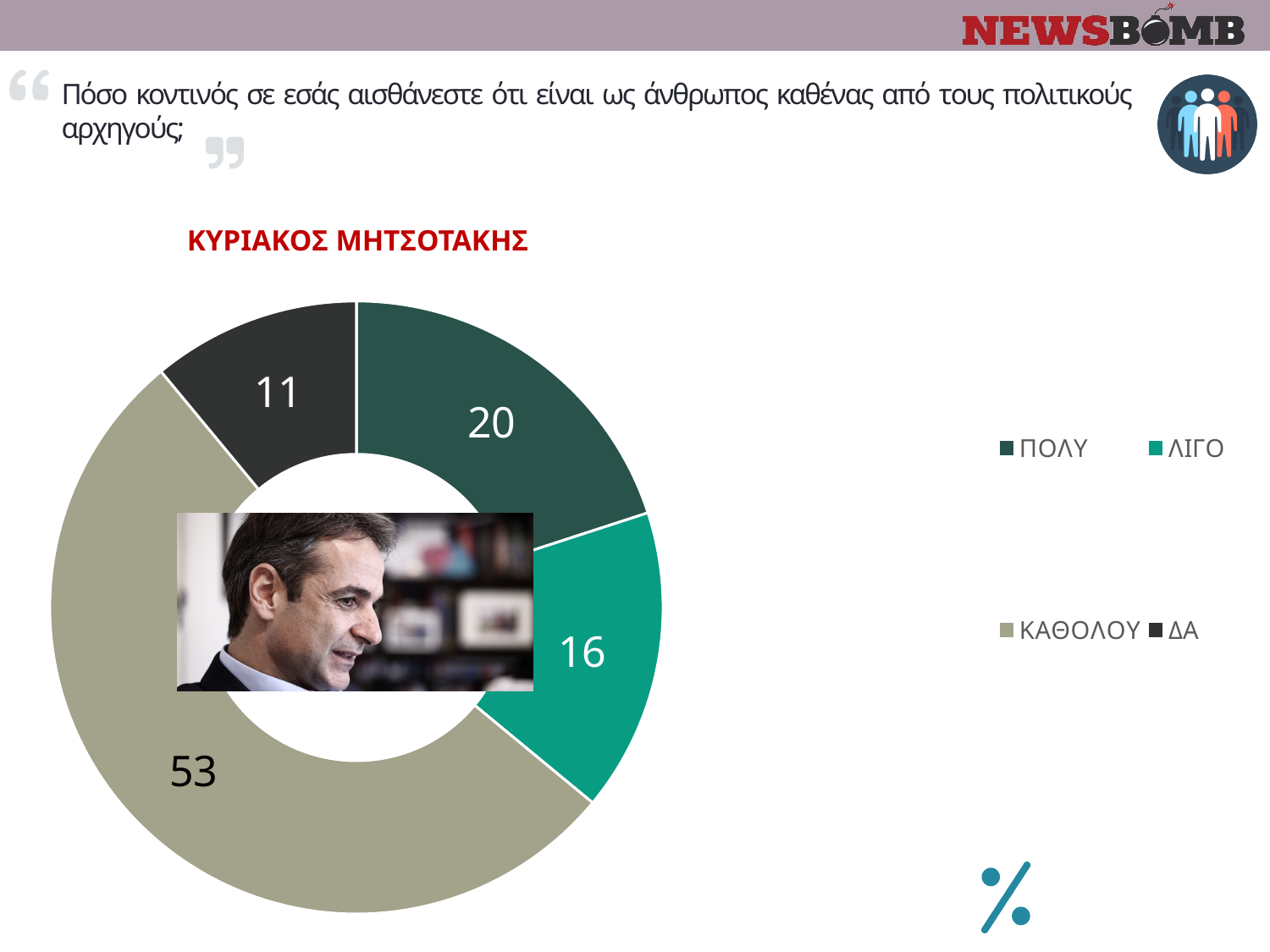
What value is shown for ΠΟΛΥ in the ΚΥΡΙΑΚΟΣ ΜΗΤΣΟΤΑΚΗΣ chart? 20 Which category has the largest slice in the ΚΥΡΙΑΚΟΣ ΜΗΤΣΟΤΑΚΗΣ chart? ΚΑΘΟΛΟΥ What value is shown for ΚΑΘΟΛΟΥ in the ΚΥΡΙΑΚΟΣ ΜΗΤΣΟΤΑΚΗΣ chart? 53 What is the difference between the ΚΑΘΟΛΟΥ and ΠΟΛΥ values in the ΚΥΡΙΑΚΟΣ ΜΗΤΣΟΤΑΚΗΣ chart? 33 Which category has the smallest slice in the ΚΥΡΙΑΚΟΣ ΜΗΤΣΟΤΑΚΗΣ chart? ΔΑ What is the title of the chart on the slide? ΚΥΡΙΑΚΟΣ ΜΗΤΣΟΤΑΚΗΣ Which is larger in the ΚΥΡΙΑΚΟΣ ΜΗΤΣΟΤΑΚΗΣ chart, ΠΟΛΥ or ΛΙΓΟ? ΠΟΛΥ What value is shown for ΛΙΓΟ in the ΚΥΡΙΑΚΟΣ ΜΗΤΣΟΤΑΚΗΣ chart? 16 What is the difference between the ΠΟΛΥ and ΛΙΓΟ values in the ΚΥΡΙΑΚΟΣ ΜΗΤΣΟΤΑΚΗΣ chart? 4 What value is shown for ΔΑ in the ΚΥΡΙΑΚΟΣ ΜΗΤΣΟΤΑΚΗΣ chart? 11 How many categories are shown in the ΚΥΡΙΑΚΟΣ ΜΗΤΣΟΤΑΚΗΣ chart? 4 What kind of chart is used for ΚΥΡΙΑΚΟΣ ΜΗΤΣΟΤΑΚΗΣ? Doughnut (pie) chart